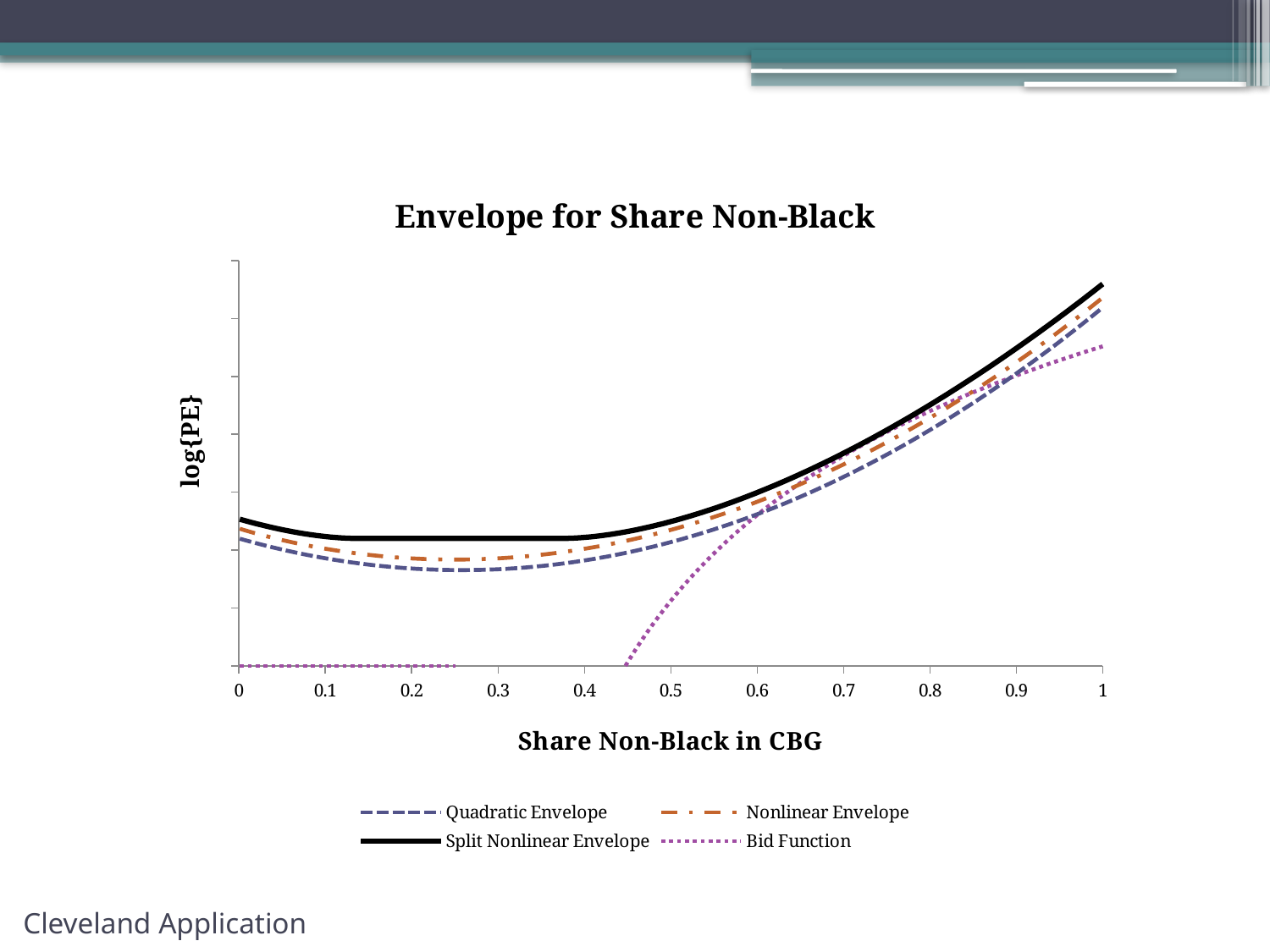
How many tick labels are shown on the x axis? 11 What is the label on the x axis of the chart? Share Non-Black in CBG At a share of 1, which is higher, the Nonlinear Envelope or the Bid Function? Nonlinear Envelope What is the title of the chart? Envelope for Share Non-Black Which series has the highest value at a share of 0.3? Split Nonlinear Envelope What kind of chart is shown on the slide? line chart Does the Quadratic Envelope rise or fall as the share goes from 0 to 0.3? fall Which series has the lowest value at a share of 1? Bid Function Does the Split Nonlinear Envelope rise or fall as the share goes from 0.5 to 1? rise Which series has the highest value at a share of 1? Split Nonlinear Envelope How many series does the legend list? 4 At a share of 0.6, which is higher, the Split Nonlinear Envelope or the Quadratic Envelope? Split Nonlinear Envelope